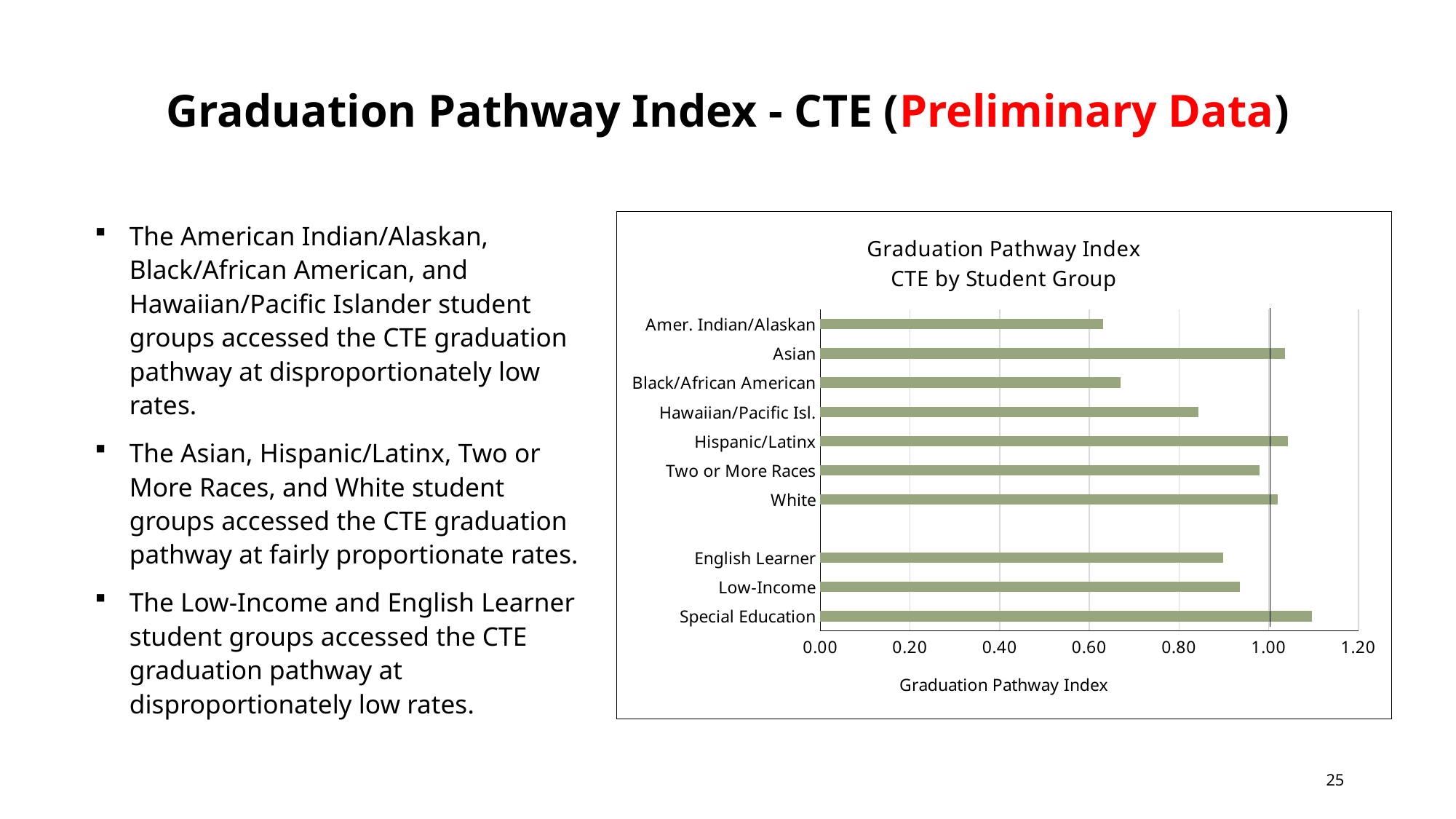
What is the label on the horizontal axis of the chart? Graduation Pathway Index Is the value for Low-Income greater or less than 1.00? less What is the title of the chart? Graduation Pathway Index CTE by Student Group Is the value for Special Education greater or less than 1.00? greater Which is larger, the value for Special Education or the value for English Learner? Special Education Which student group has the highest Graduation Pathway Index in the chart? Special Education Is the value for Black/African American greater or less than 0.80? less How many student groups are plotted in the chart? 10 Which is larger, the value for Hawaiian/Pacific Isl. or the value for Black/African American? Hawaiian/Pacific Isl. What kind of chart is shown on the slide? bar chart